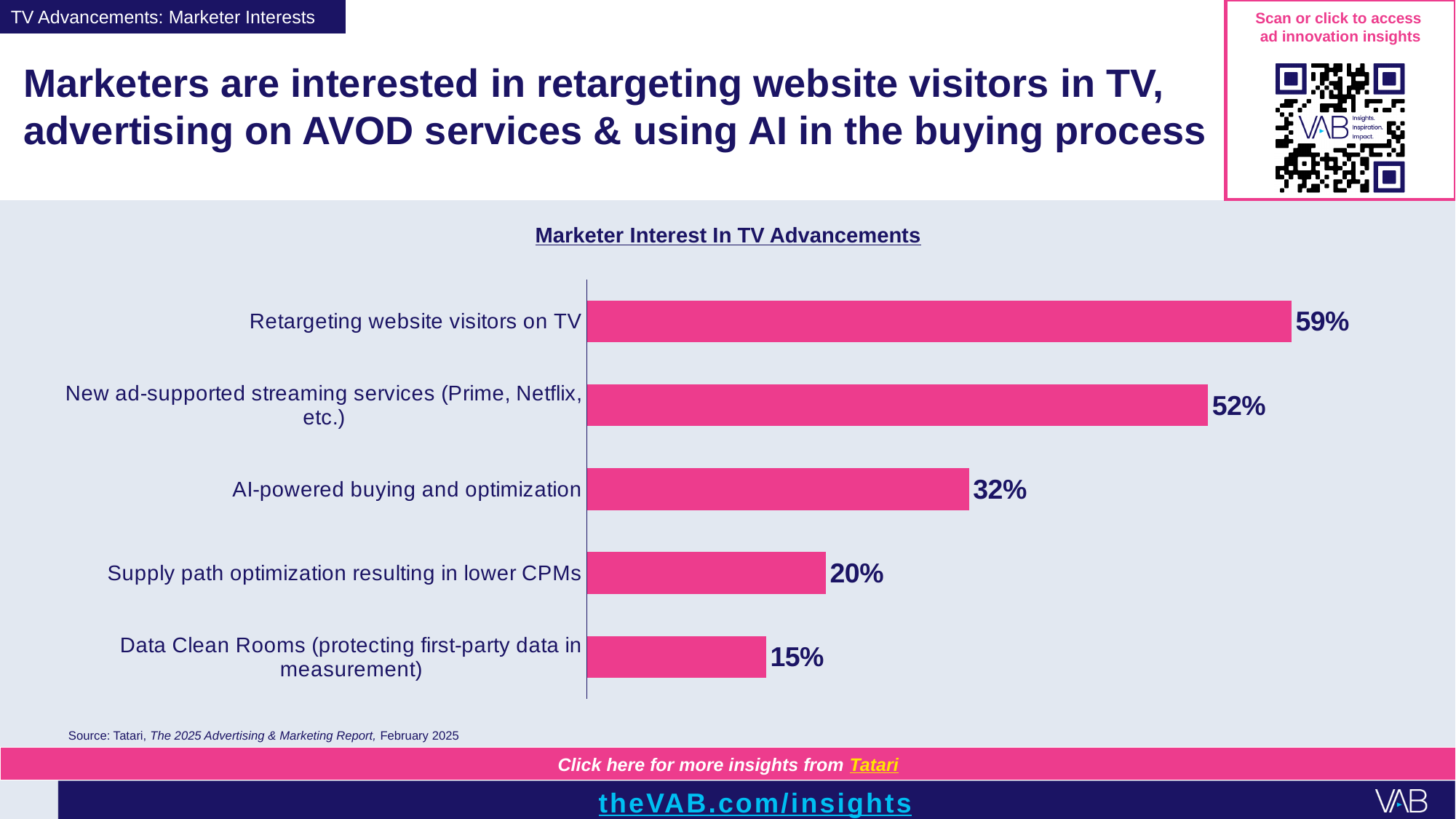
What percentage of marketers are interested in retargeting website visitors on TV? 59% Which TV advancement has the lowest marketer interest? Data Clean Rooms (protecting first-party data in measurement) What is the title of the chart? Marketer Interest In TV Advancements How many TV advancements are shown in the chart? 5 What percentage is shown for Data Clean Rooms (protecting first-party data in measurement)? 15% What is the source of the chart data? Tatari, The 2025 Advertising & Marketing Report, February 2025 What is the difference in percentage points between retargeting website visitors on TV and new ad-supported streaming services? 7 What type of chart is shown on the slide? Bar chart Which has a higher value: supply path optimization resulting in lower CPMs or Data Clean Rooms? Supply path optimization resulting in lower CPMs What is the difference in percentage points between AI-powered buying and optimization and supply path optimization resulting in lower CPMs? 12 What is the value shown for AI-powered buying and optimization? 32% Which TV advancement has the highest marketer interest? Retargeting website visitors on TV